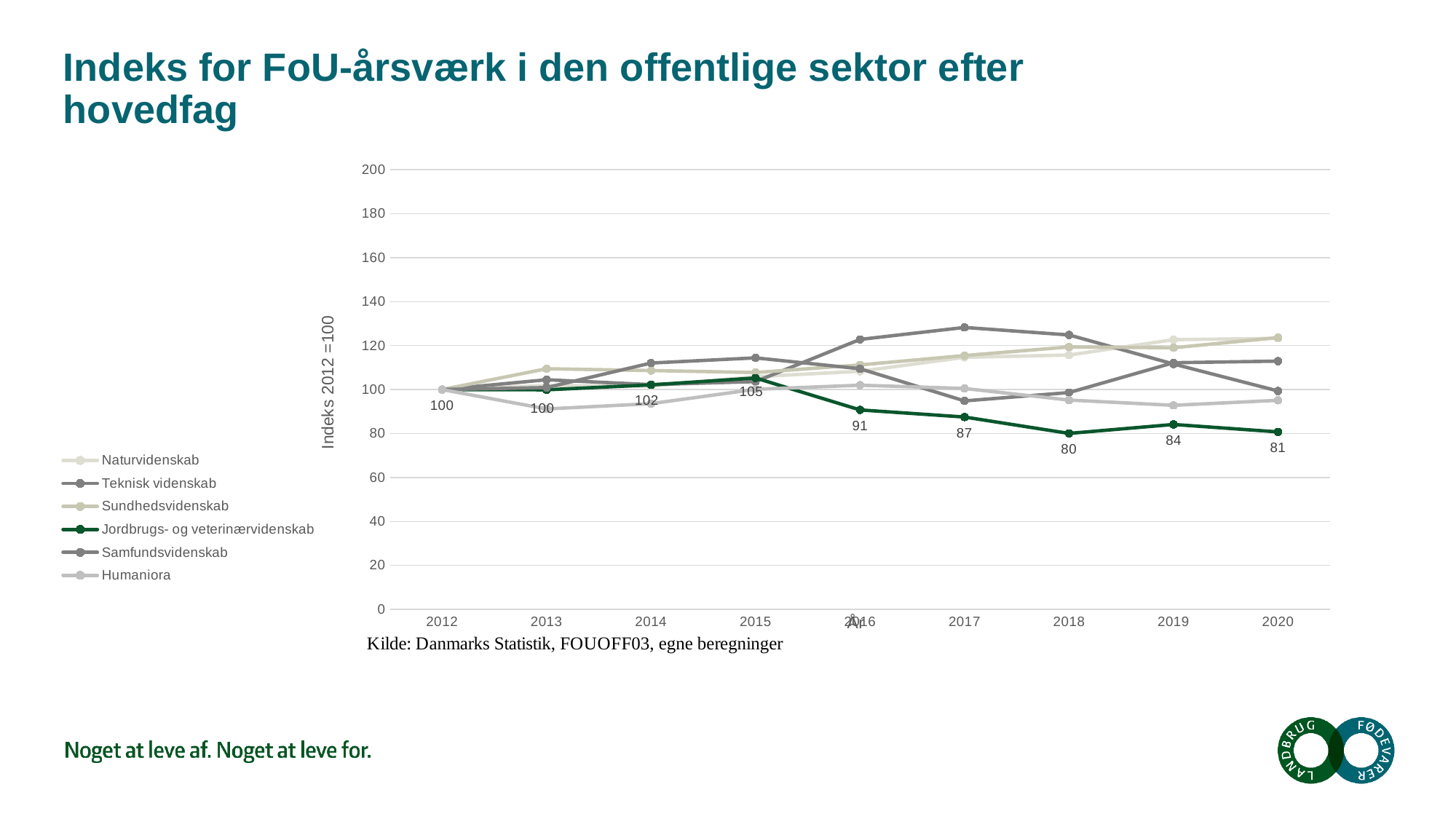
What is the difference between the Jordbrugs- og veterinærvidenskab values in 2015 and 2020? 24 What is the value for Jordbrugs- og veterinærvidenskab in 2015? 105 In which year does Jordbrugs- og veterinærvidenskab reach its lowest value? 2018 How many series does the legend list? 6 What is the value for Jordbrugs- og veterinærvidenskab in 2016? 91 Is the value for Humaniora in 2019 greater or less than 100? less Which is larger for Jordbrugs- og veterinærvidenskab: the value in 2019 or in 2020? 2019 What is the value for Jordbrugs- og veterinærvidenskab in 2020? 81 Is the value for Samfundsvidenskab in 2017 greater or less than 120? less In which year does Jordbrugs- og veterinærvidenskab reach its highest value? 2015 What kind of chart is shown on the slide? Line chart How many years are shown on the x axis? 9